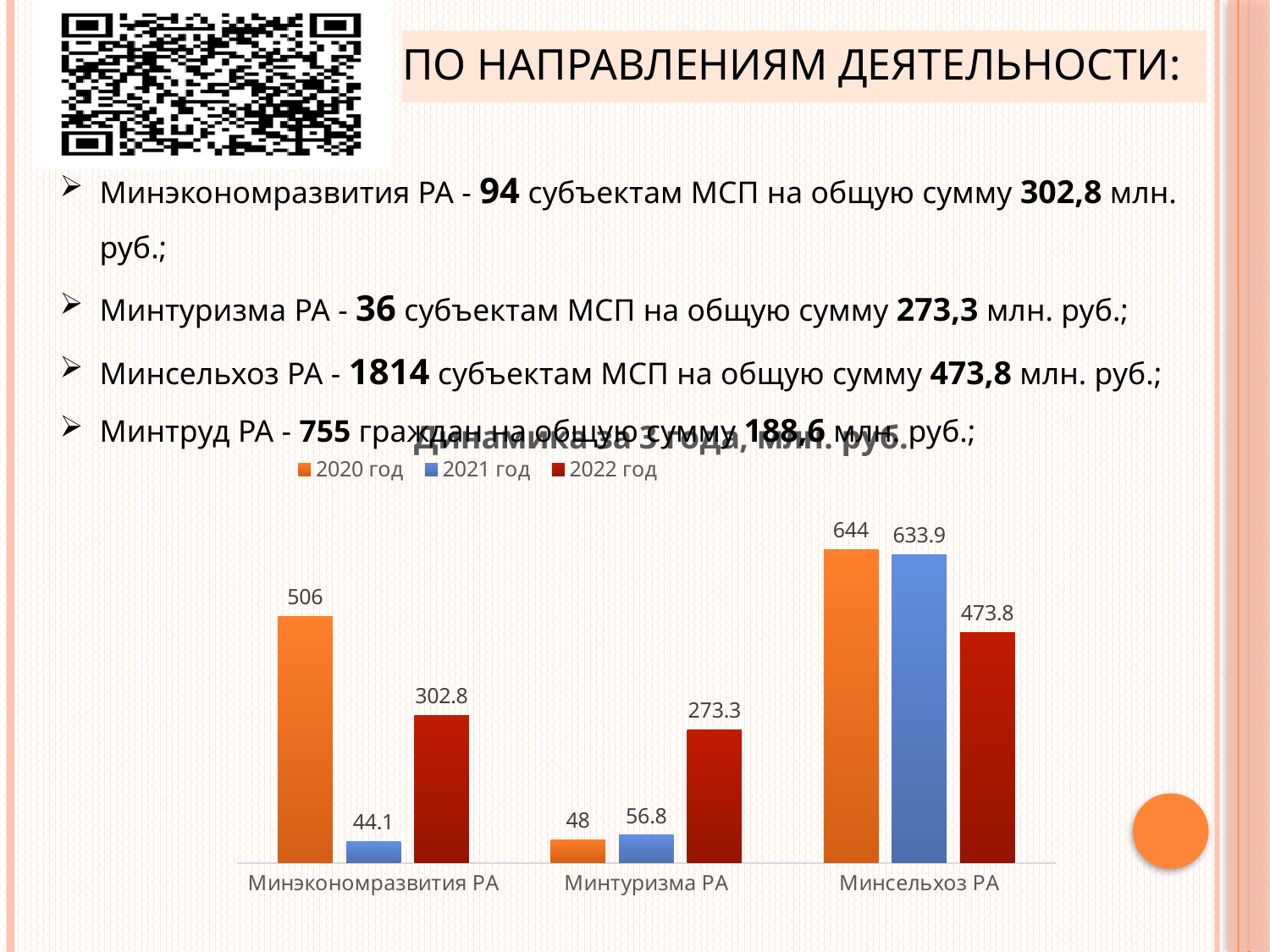
How many categories are shown on the x axis? 3 What is the value for Минтуризма РА in the 2022 год series? 273.3 What kind of chart is shown on the slide? Bar chart Which is larger for Минтуризма РА: the 2020 год value or the 2021 год value? 2021 год Which category has the lowest value in the 2020 год series? Минтуризма РА What is the value for Минсельхоз РА in the 2021 год series? 633.9 What is the value for Минэкономразвития РА in the 2021 год series? 44.1 How many series does the legend list? 3 Which series is shown in dark red in the legend? 2022 год What is the difference between the 2020 год and 2022 год values for Минсельхоз РА? 170.2 What is the value for Минэкономразвития РА in the 2020 год series? 506 Which category has the highest value in the 2022 год series? Минсельхоз РА